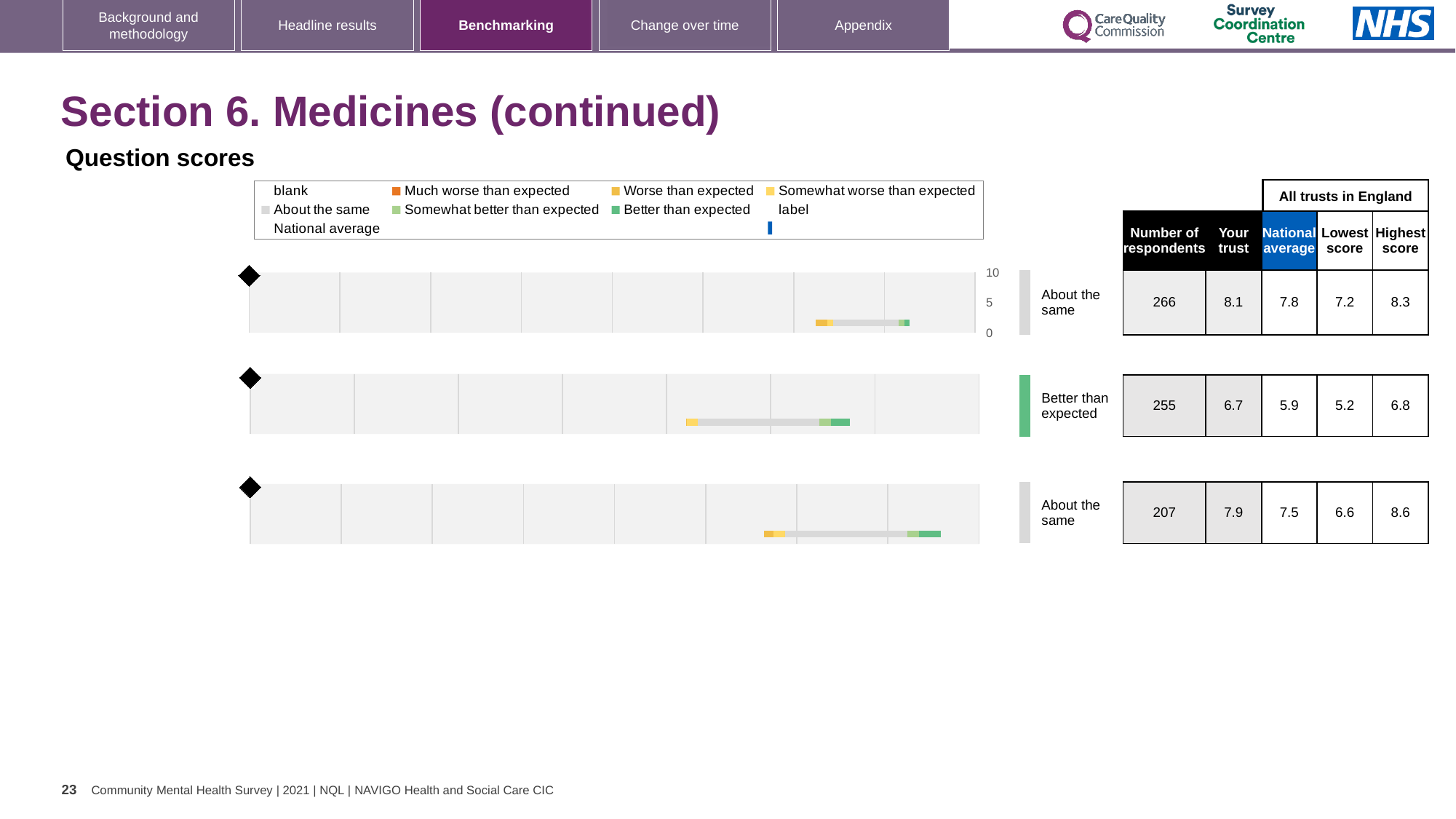
For the middle row (rated 'Better than expected'), what is the 'Your trust' score? 6.7 What kind of chart is used for the three question score rows on the slide? bar chart For the top row, what is the national average score? 7.8 How many question score charts (rows) are shown on the slide? 3 For the top row, which is larger: the 'Your trust' score or the national average? Your trust What is the highest score among all trusts in England for the bottom row? 8.6 Which row has the highest 'Your trust' score? the top row (8.1) Which row has the lowest 'Lowest score' value? the middle row (5.2) What colour does the legend use for 'Better than expected'? green For the middle row, what is the difference between the 'Your trust' score and the national average? 0.8 How many respondents are listed for the bottom row? 207 What is the maximum value shown on the score axis of the top chart? 10